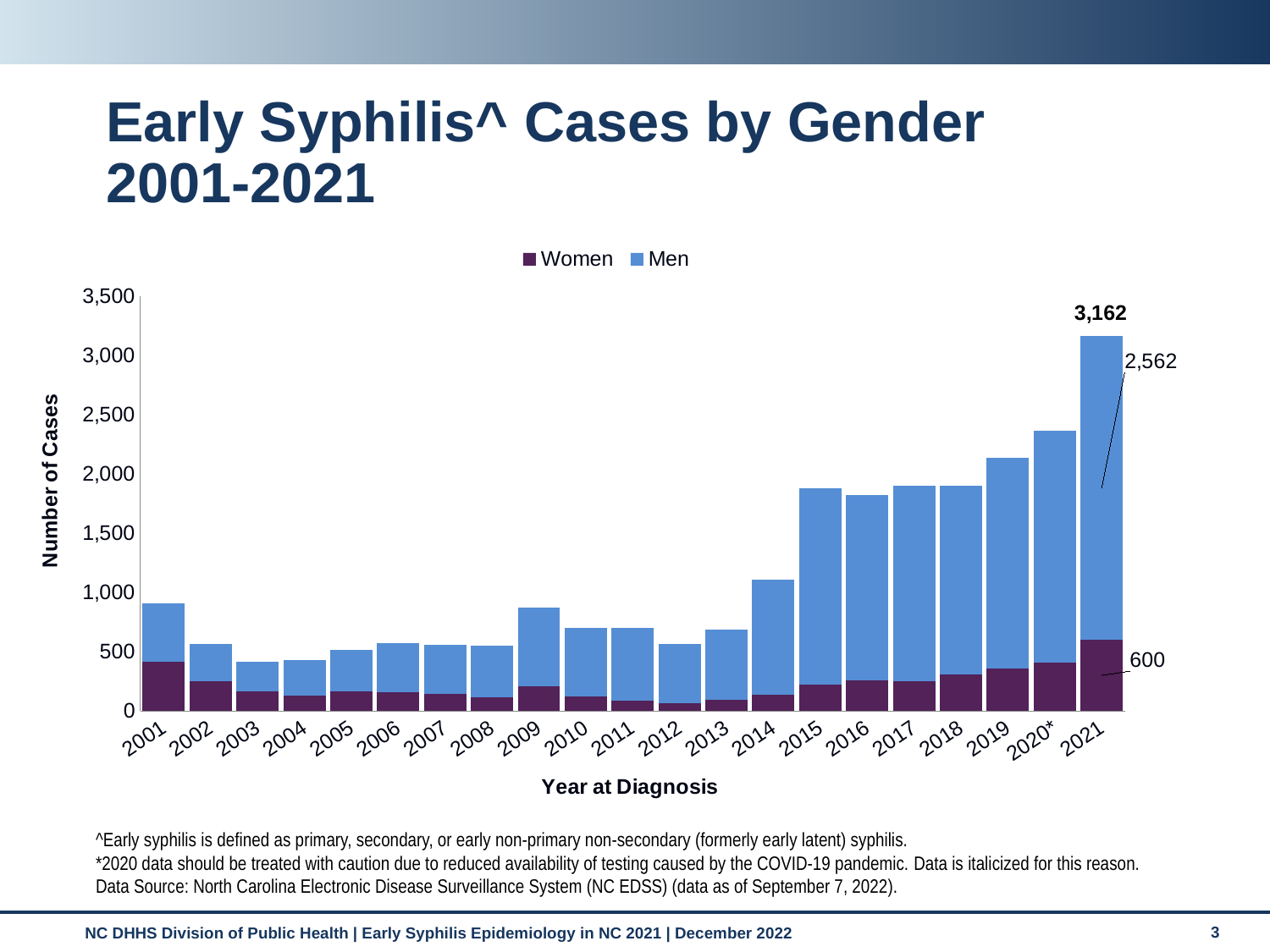
Do total early syphilis cases rise or fall from 2014 to 2021? Rise What kind of chart is shown on the slide? Stacked bar chart Which year has more total cases, 2009 or 2010? 2009 Is the total number of cases in 2015 greater or less than 1,500? greater Which year has the highest total number of early syphilis cases? 2021 How many years are shown on the x axis of the chart? 21 What is the number of early syphilis cases among men in 2021? 2,562 Is the total number of cases in 2003 greater or less than 500? less What is the total number of early syphilis cases in 2021? 3,162 How many series does the legend list? 2 How many more cases were there among men than among women in 2021? 1,962 What is the number of early syphilis cases among women in 2021? 600